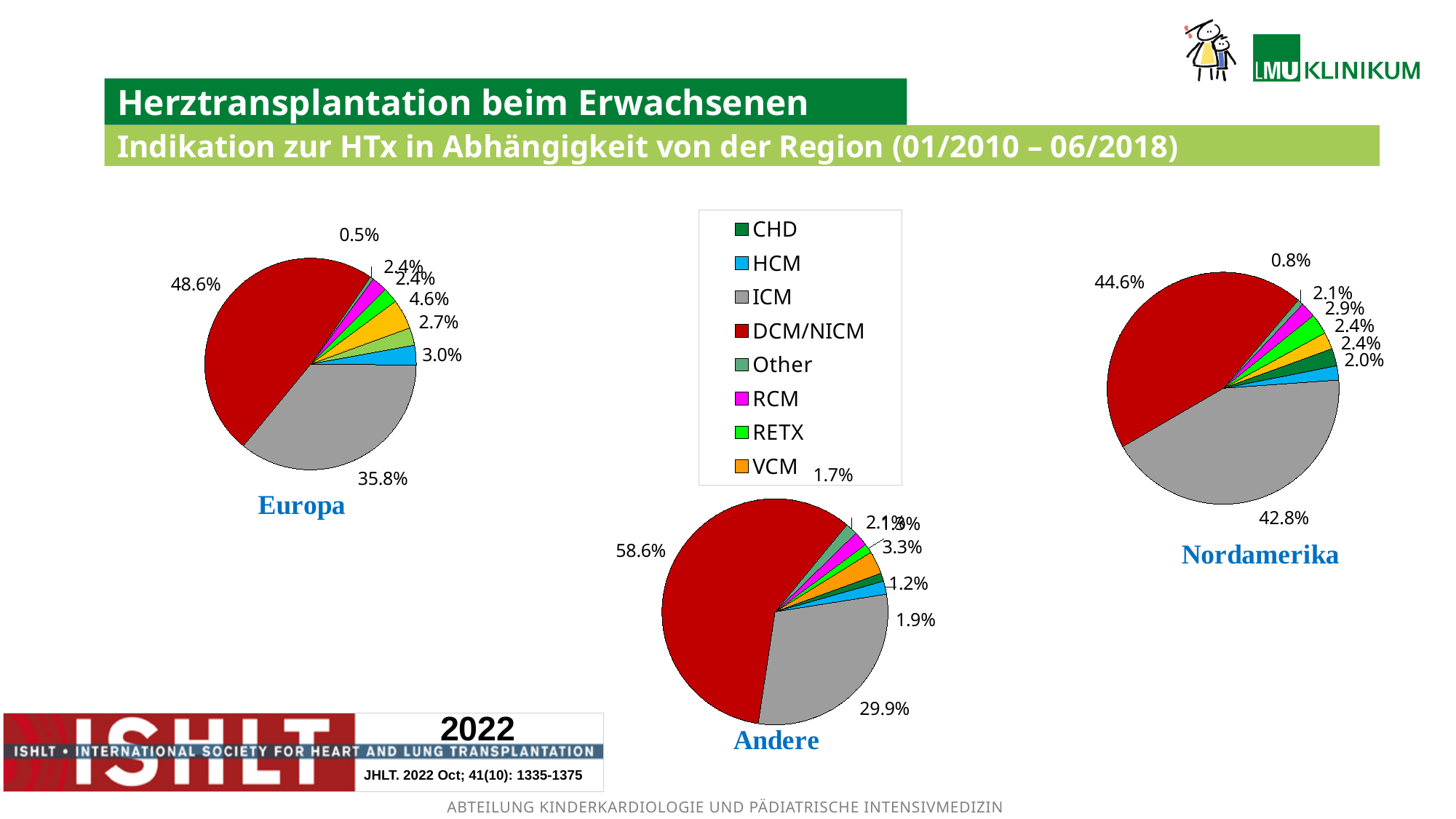
In the Europa pie chart, what share is DCM/NICM? 48.6% In the Nordamerika pie chart, what share is DCM/NICM? 44.6% What type of chart is used for the Nordamerika region? Pie chart In the Europa pie chart, what share is ICM? 35.8% In the Europa pie chart, which category has the smallest share? Other In the Europa pie chart, which category has the largest share? DCM/NICM How many categories does the legend list? 8 In the Andere pie chart, what share is ICM? 29.9% Which region's pie chart has the larger DCM/NICM share, Europa or Andere? Andere In the Europa pie chart, what is the difference between the DCM/NICM share and the ICM share? 12.8% In the Nordamerika pie chart, what share is ICM? 42.8% In the Andere pie chart, what share is DCM/NICM? 58.6%